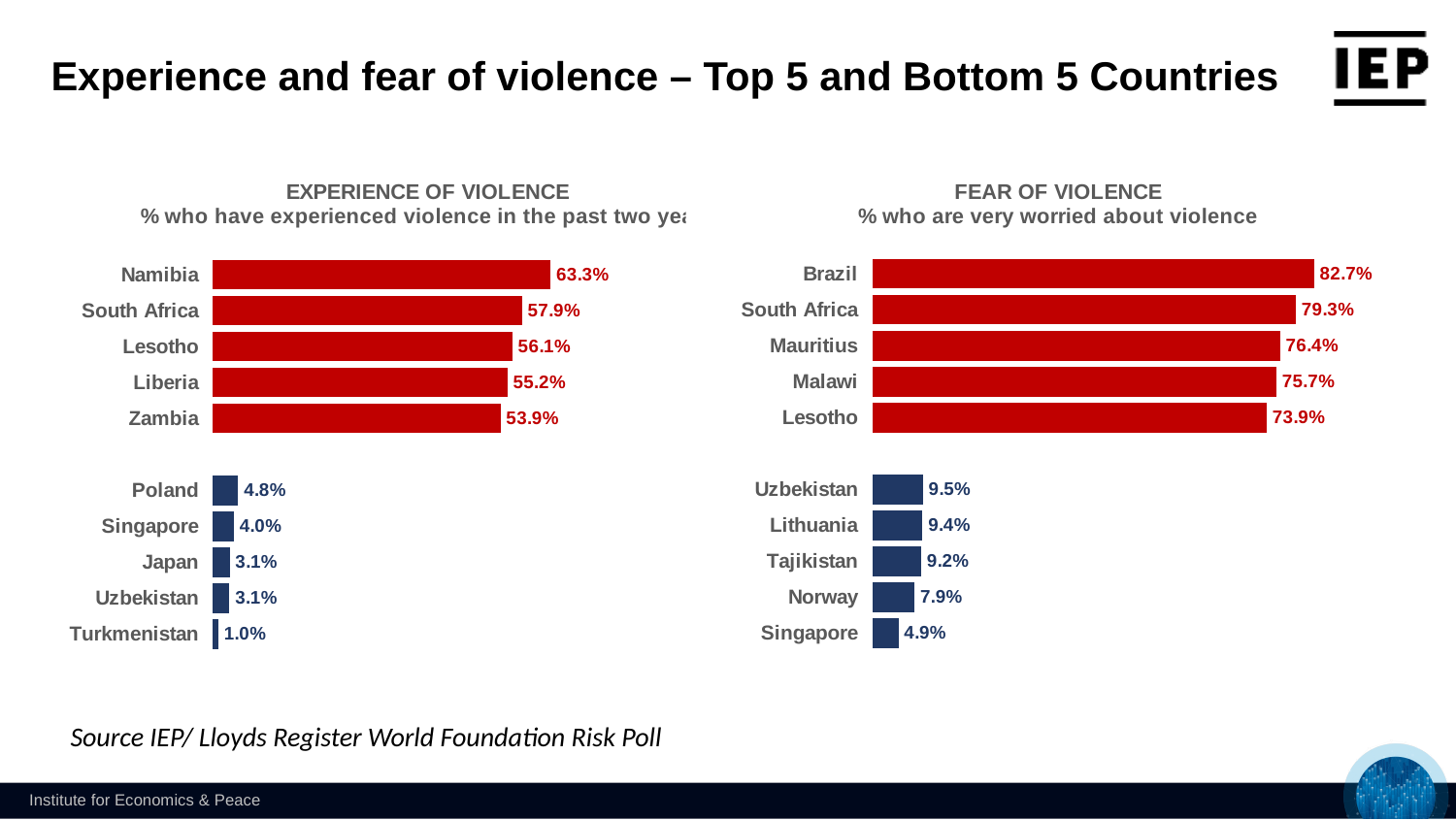
In the Fear of Violence chart, what is the value for Norway? 7.9% In the Fear of Violence chart, what is the value for Mauritius? 76.4% How many countries are shown in the Experience of Violence chart? 10 In the Experience of Violence chart, what is the value for Uzbekistan? 3.1% In the Fear of Violence chart, which country has the highest value? Brazil What is the subtitle of the Fear of Violence chart? % who are very worried about violence In the Fear of Violence chart, which is larger, the value for Malawi or the value for Lesotho? Malawi In the Fear of Violence chart, what is the difference between Brazil and Singapore? 77.8% In the Experience of Violence chart, what is the difference between Namibia and South Africa? 5.4% In the Experience of Violence chart, what is the value for Namibia? 63.3% What kind of chart is the Fear of Violence chart? Bar chart In the Experience of Violence chart, which country has the lowest value? Turkmenistan